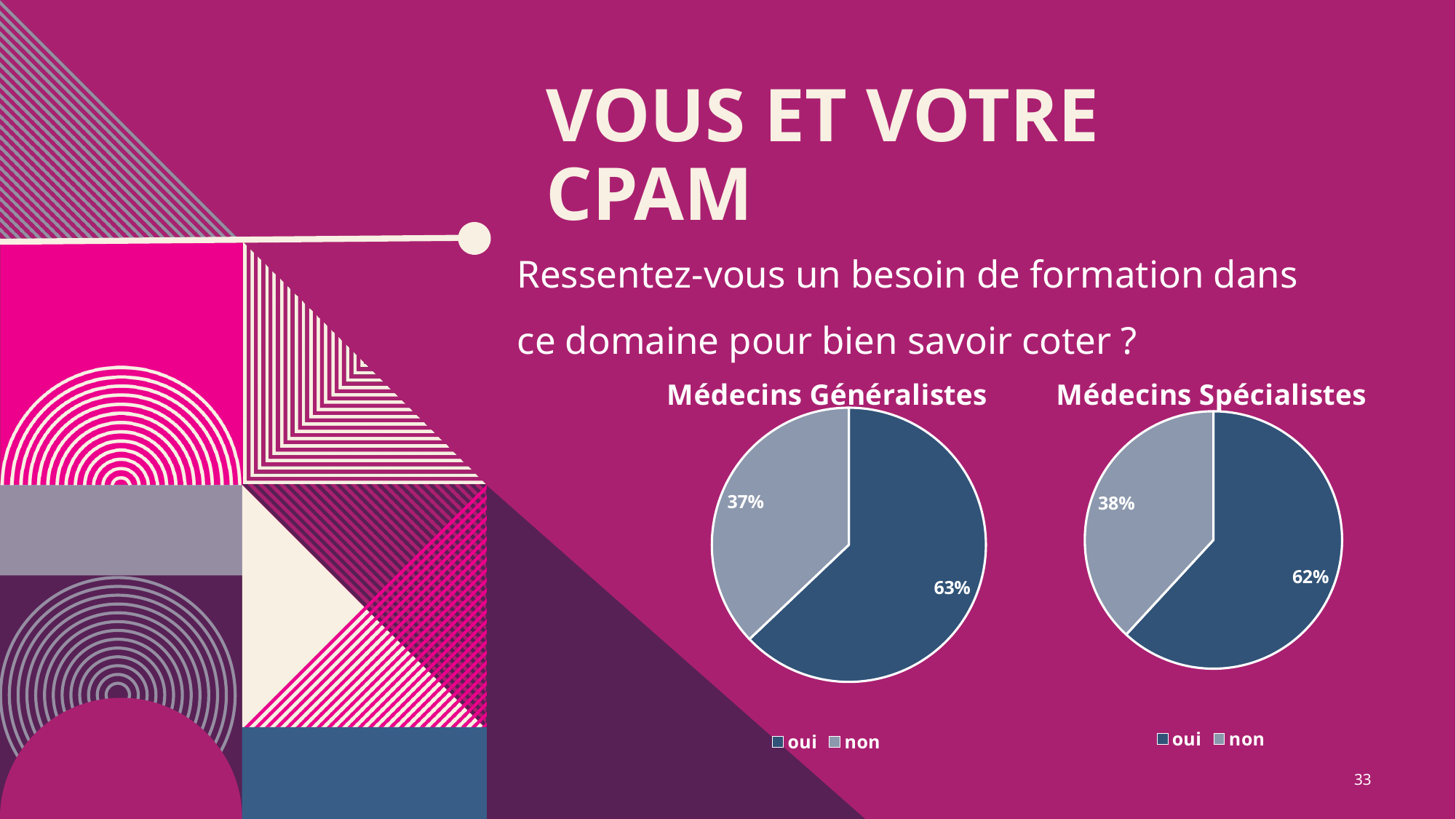
How many slices does the 'Médecins Spécialistes' pie chart have? 2 In the 'Médecins Spécialistes' chart, what share of respondents answered 'non'? 38% In the 'Médecins Généralistes' chart, which answer has the largest slice? oui In the 'Médecins Généralistes' chart, what is the difference between the 'oui' and 'non' shares? 26% In the 'Médecins Spécialistes' chart, is the 'oui' slice larger or smaller than the 'non' slice? larger In the 'Médecins Spécialistes' chart, what is the difference between the 'oui' and 'non' shares? 24% In the 'Médecins Spécialistes' chart, which answer has the smallest slice? non How many entries does the legend of the 'Médecins Généralistes' chart list? 2 In the 'Médecins Généralistes' chart, what share of respondents answered 'oui'? 63% In the 'Médecins Généralistes' chart, what share of respondents answered 'non'? 37% In the 'Médecins Spécialistes' chart, what share of respondents answered 'oui'? 62% What kind of chart is the 'Médecins Généralistes' chart? pie chart